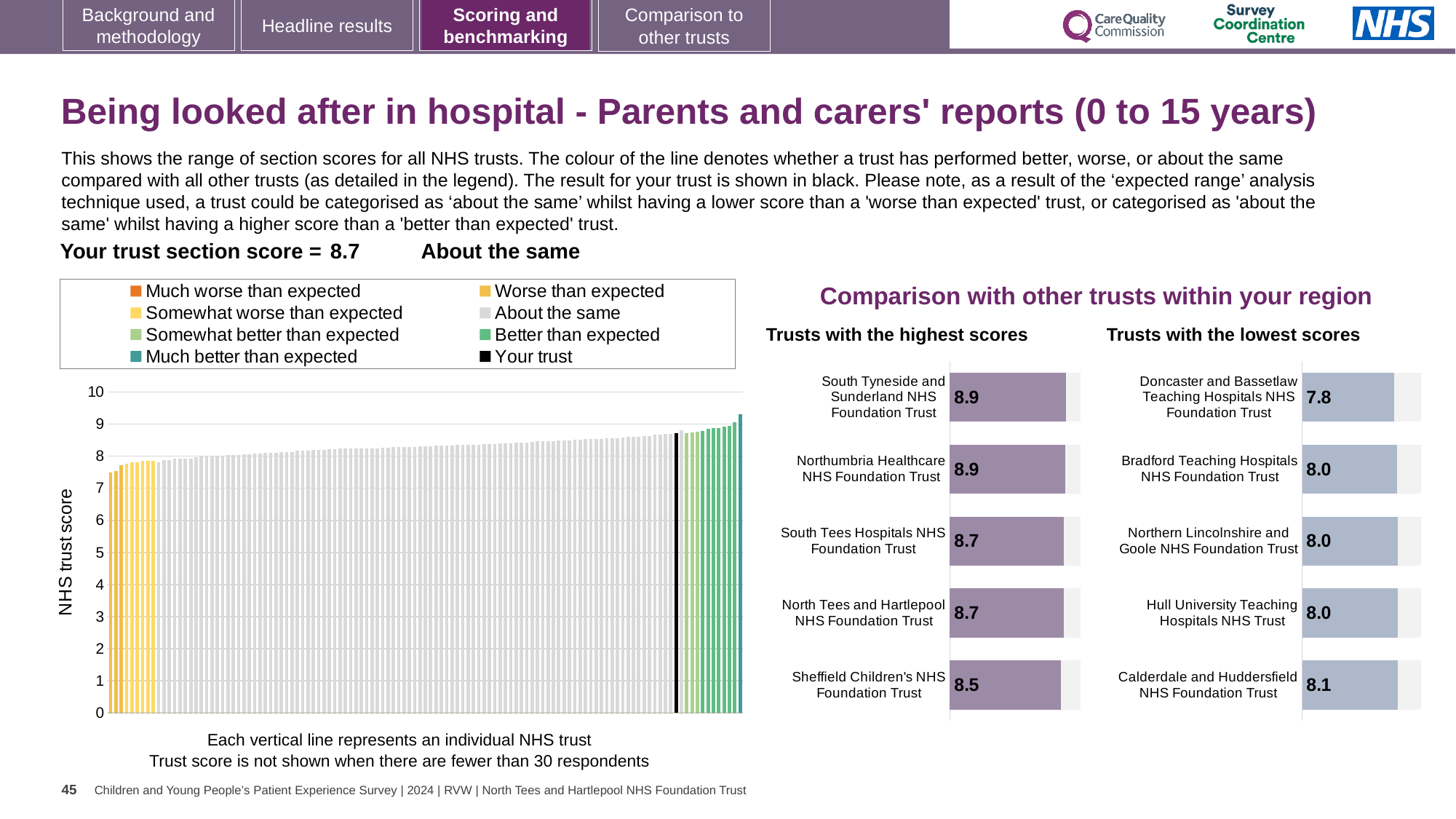
In the 'Trusts with the highest scores' chart, which trust has the lowest score? Sheffield Children's NHS Foundation Trust In the 'Trusts with the highest scores' chart, what is the score for Sheffield Children's NHS Foundation Trust? 8.5 How many trusts are shown in the 'Trusts with the lowest scores' chart? 5 In the 'Trusts with the lowest scores' chart, which is larger: the score for Calderdale and Huddersfield NHS Foundation Trust or Doncaster and Bassetlaw Teaching Hospitals NHS Foundation Trust? Calderdale and Huddersfield NHS Foundation Trust How many entries does the legend of the large chart on the left list? 8 In the 'Trusts with the lowest scores' chart, which trust has the lowest score? Doncaster and Bassetlaw Teaching Hospitals NHS Foundation Trust In the large chart on the left, do the trust scores rise or fall from left to right along the x axis? rise In the 'Trusts with the lowest scores' chart, what is the score for Doncaster and Bassetlaw Teaching Hospitals NHS Foundation Trust? 7.8 In the large chart on the left showing the range of section scores, is the value for 'Your trust' (the black bar) greater or less than 8? greater In the 'Trusts with the lowest scores' chart, which trust has the highest score? Calderdale and Huddersfield NHS Foundation Trust In the 'Trusts with the highest scores' chart, what is the difference between the scores of South Tyneside and Sunderland NHS Foundation Trust and Sheffield Children's NHS Foundation Trust? 0.4 In the 'Trusts with the highest scores' chart, what is the score for South Tees Hospitals NHS Foundation Trust? 8.7